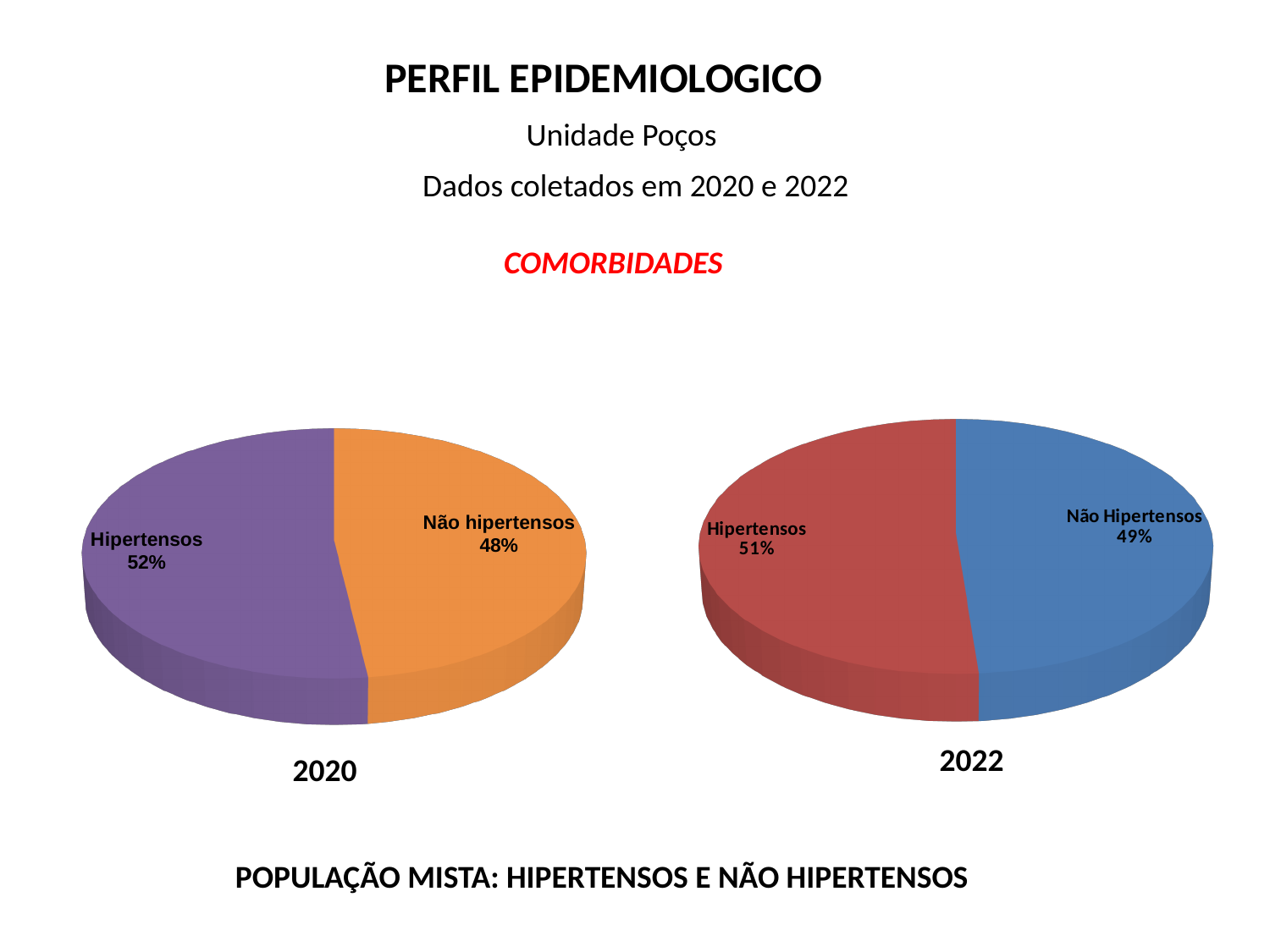
In the 2020 pie chart, what share is labelled for Hipertensos? 52% How many slices does the 2020 pie chart have? 2 In the 2020 pie chart, what share is labelled for Não hipertensos? 48% In the 2022 pie chart, what is the difference in percentage points between Hipertensos and Não Hipertensos? 2 percentage points In the 2022 pie chart, what colour is the Hipertensos slice? Red Which is larger: the Hipertensos share in the 2020 chart or the Hipertensos share in the 2022 chart? 2020 In the 2020 pie chart, what is the difference in percentage points between Hipertensos and Não hipertensos? 4 percentage points In the 2022 pie chart, which slice is the smallest? Não Hipertensos In the 2022 pie chart, what share is labelled for Hipertensos? 51% In the 2020 pie chart, which slice is the largest? Hipertensos In the 2022 pie chart, what share is labelled for Não Hipertensos? 49% What kind of chart is used for the 2022 data? Pie chart